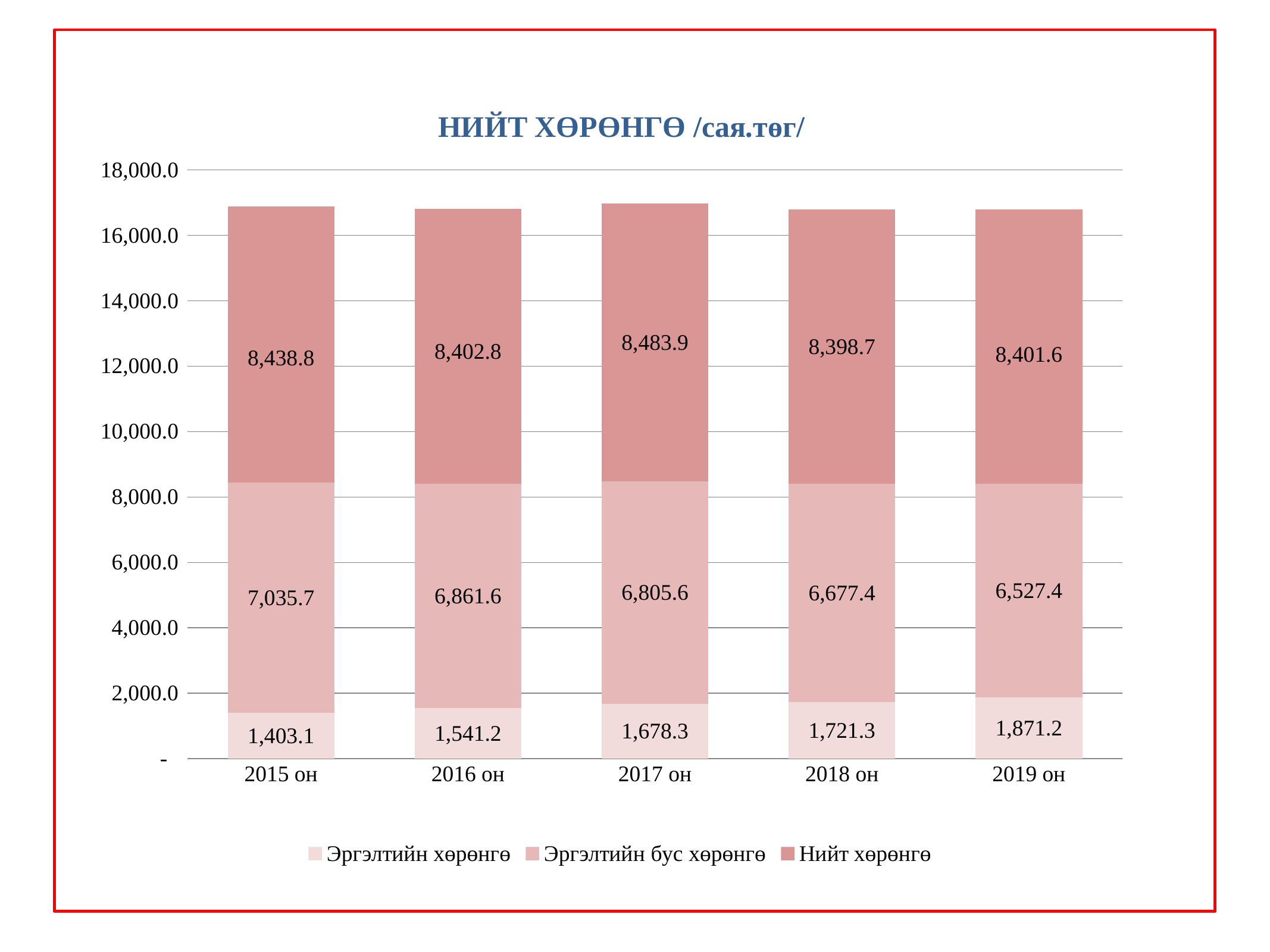
What is the total of the stacked bar for 2015 он? 16,877.6 What is the value of Эргэлтийн бус хөрөнгө for 2018 он? 6,677.4 How many years are shown on the x axis? 5 What is the value of Эргэлтийн хөрөнгө for 2015 он? 1,403.1 What kind of chart is shown on the slide? Stacked bar chart Does Эргэлтийн хөрөнгө rise or fall from 2015 он to 2019 он? Rise Which is larger: Эргэлтийн бус хөрөнгө in 2016 он or in 2017 он? 2016 он What is the difference between the Эргэлтийн хөрөнгө values for 2019 он and 2015 он? 468.1 What is the value of Нийт хөрөнгө for 2017 он? 8,483.9 In which year is Эргэлтийн хөрөнгө highest? 2019 он How many series does the legend list? 3 In which year is Эргэлтийн бус хөрөнгө lowest? 2019 он